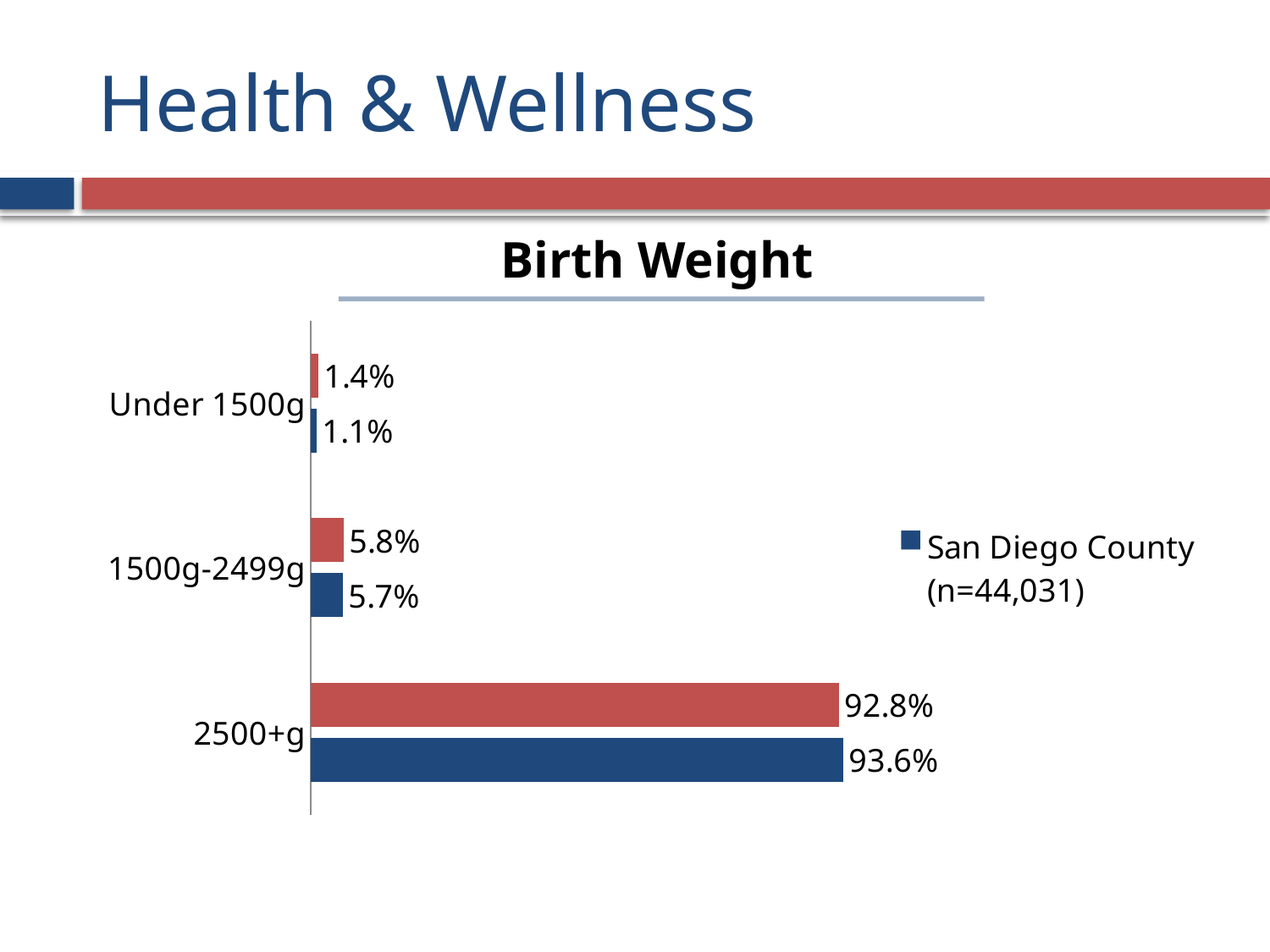
Which birth weight category has the lowest San Diego County value? Under 1500g How many birth weight categories are shown on the chart? 3 What kind of chart is shown on the slide? bar chart What is the value of the red bar for 1500g-2499g? 5.8% How many series does the legend list? 1 Which birth weight category has the highest San Diego County value? 2500+g What is the difference between the San Diego County value and the red bar value for 2500+g? 0.8% For Under 1500g, which is larger: the red bar or the San Diego County bar? the red bar What is the San Diego County value for 2500+g? 93.6% What is the value of the red bar for 2500+g? 92.8% What is the title of the chart? Birth Weight What is the San Diego County value for Under 1500g? 1.1%